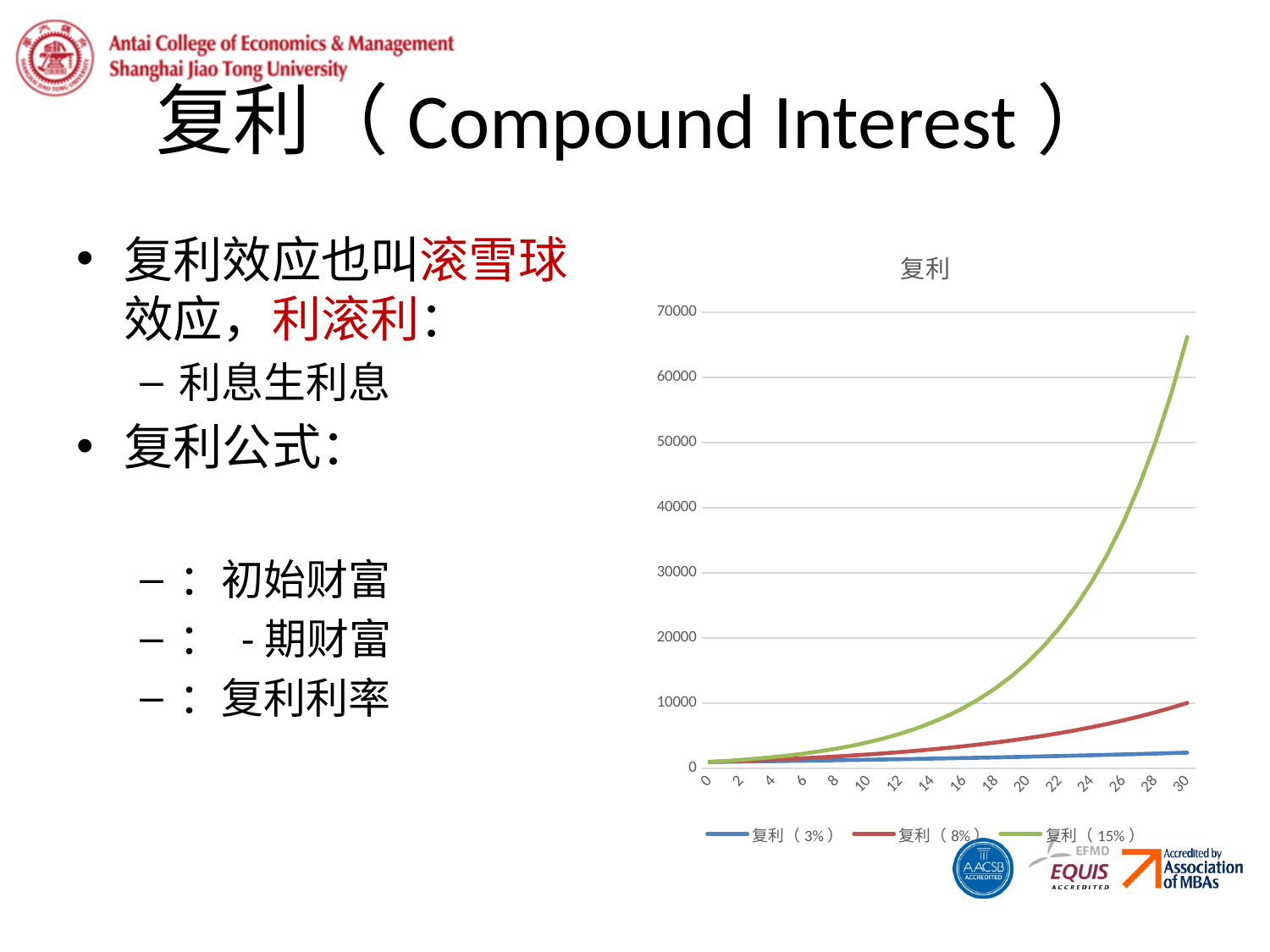
Which series is lowest at year 30? 复利（3%） How many series does the chart legend list? 3 What is the title of the chart? 复利 Which series is highest at year 30? 复利（15%） Do the values of 复利（15%） rise or fall as the years increase along the x axis? rise Which is larger at year 30: 复利（8%） or 复利（3%）? 复利（8%） Is the value of 复利（15%） at year 30 greater or less than 60000? greater What kind of chart is shown on the slide? line chart What colour is the line for 复利（8%）? red How many tick labels are shown on the x axis? 16 Is the value of 复利（3%） at year 30 greater or less than 10000? less Is the value of 复利（15%） at year 20 greater or less than 10000? greater